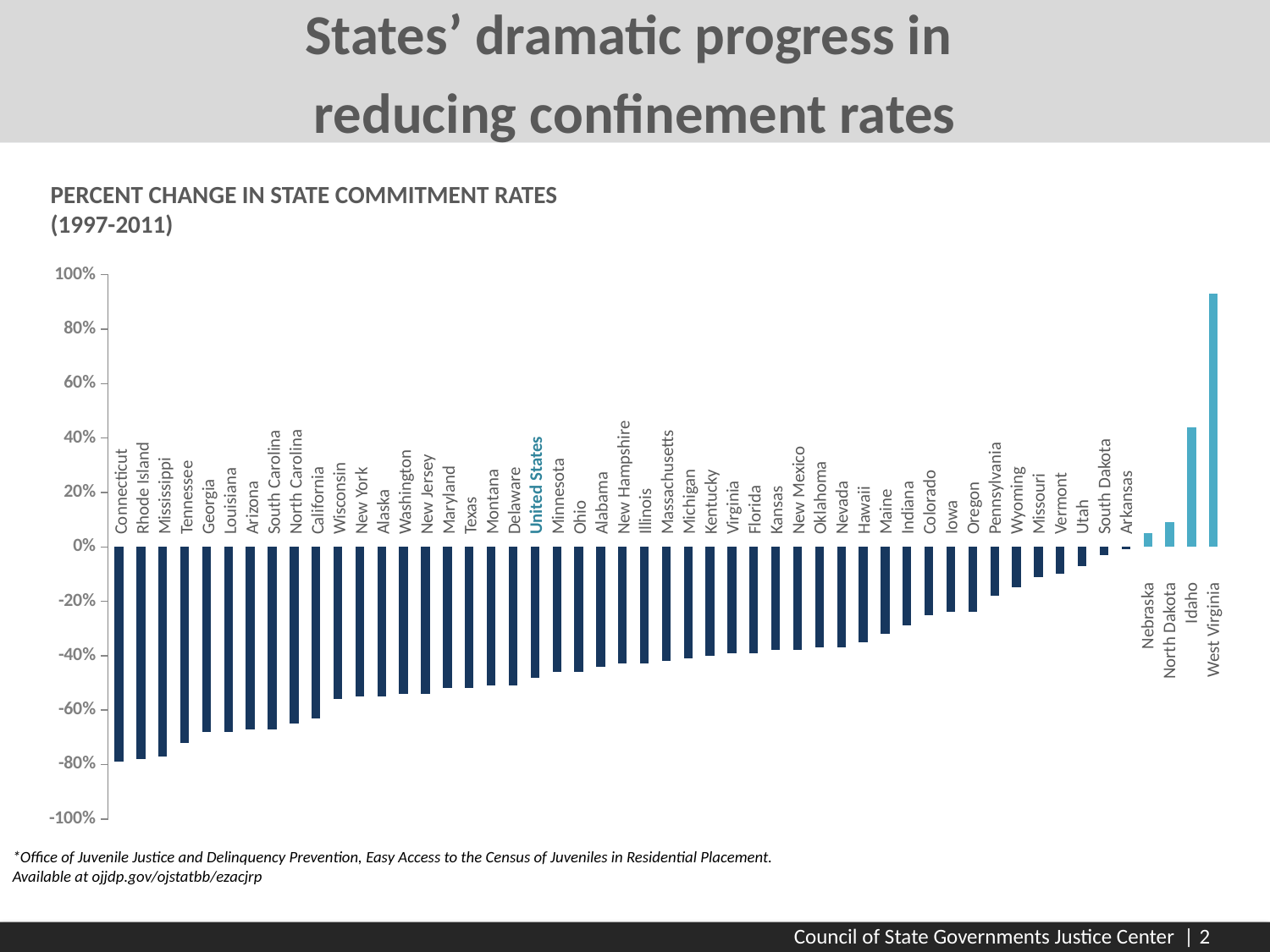
Is the value for Nebraska greater or less than 20%? less Which state has the lowest (most negative) percent change in commitment rate? Connecticut Which has the larger percent change, Idaho or Nebraska? Idaho What kind of chart is shown on the slide? bar chart Is the value for West Virginia greater or less than 80%? greater Is the value for Texas greater or less than -40%? less What is the title of the chart? PERCENT CHANGE IN STATE COMMITMENT RATES (1997-2011) Do the values generally rise or fall moving from left to right along the x axis? rise Which state has the highest percent change in commitment rate? West Virginia Which has the lower percent change, Texas or Maine? Texas